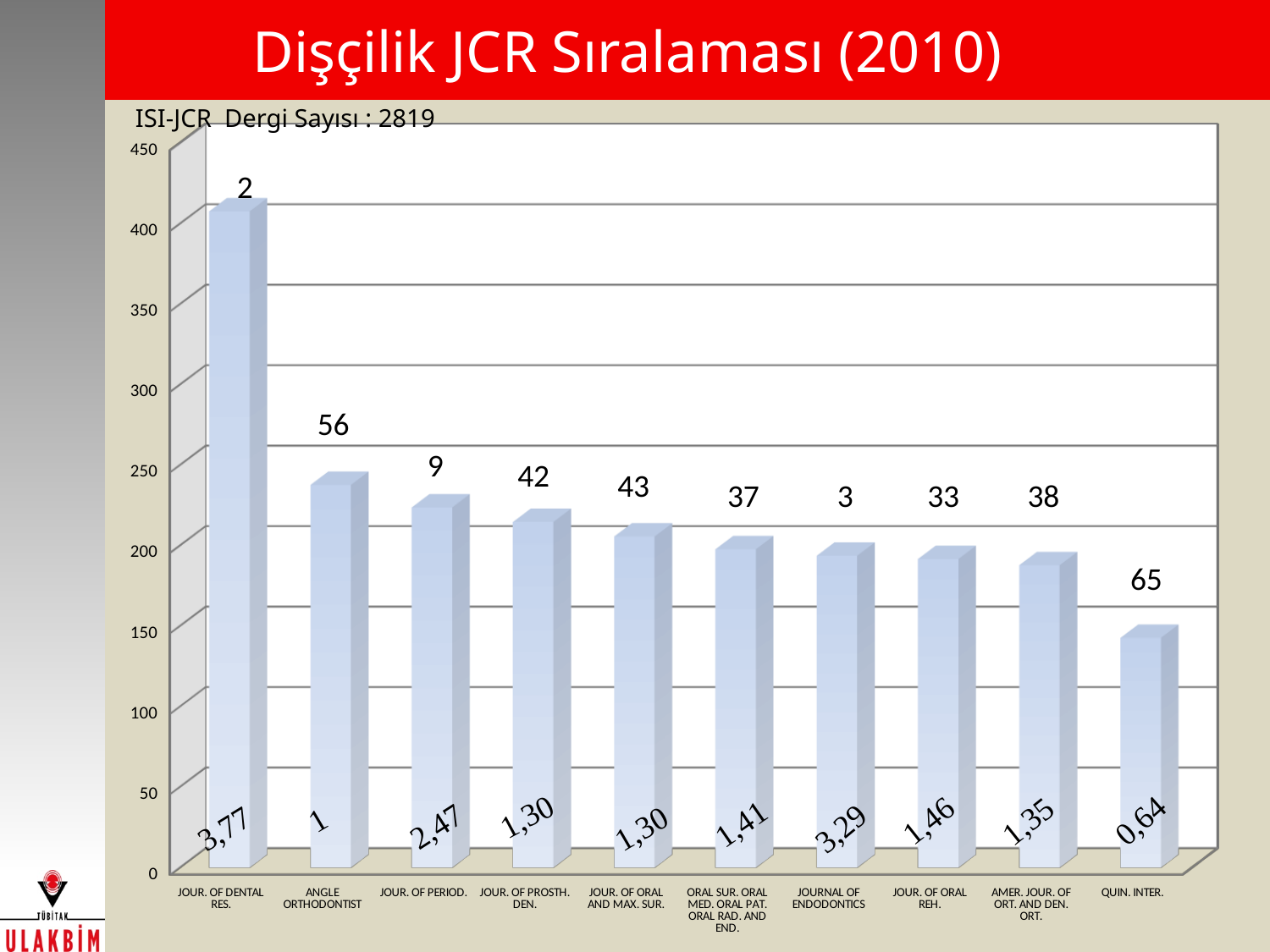
What kind of chart is shown on the slide? bar chart Is the bar for QUIN. INTER. greater or less than 200? less What number is printed inside the bar for JOUR. OF DENTAL RES.? 3,77 Which journal has the shortest bar in the chart? QUIN. INTER. Which bar is taller, JOUR. OF DENTAL RES. or ANGLE ORTHODONTIST? JOUR. OF DENTAL RES. Is the bar for ANGLE ORTHODONTIST greater or less than 200? greater Is the bar for JOUR. OF DENTAL RES. greater or less than 350? greater What number is printed above the bar for QUIN. INTER.? 65 What text appears as the chart's title above the plot area? ISI-JCR Dergi Sayısı : 2819 Do the bar heights generally rise or fall from left to right across the chart? fall Which journal has the tallest bar in the chart? JOUR. OF DENTAL RES. How many journals (bars) are shown in the chart? 10